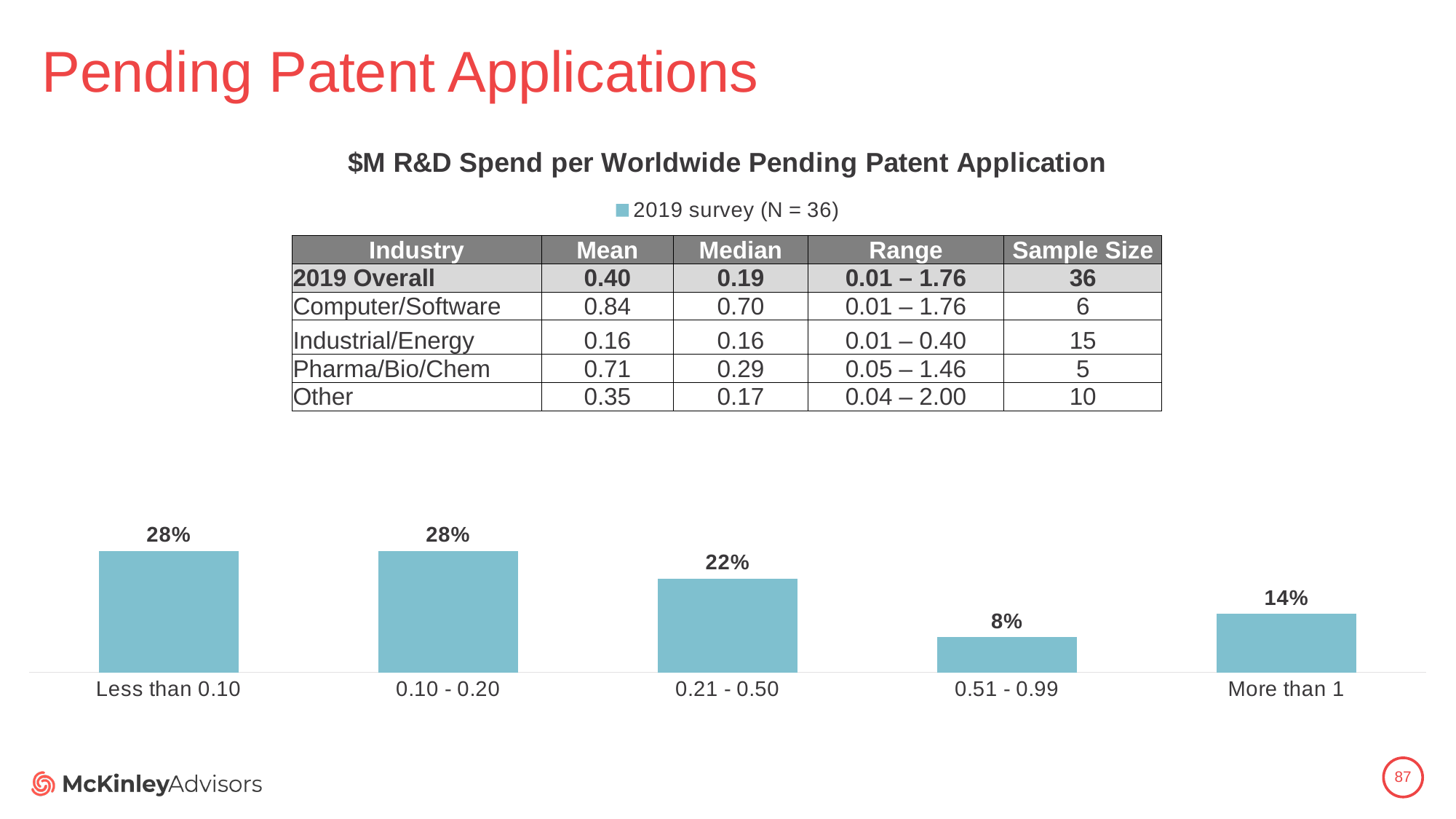
How many categories are shown on the x axis of the chart? 5 Which category has the lowest value in the chart? 0.51 - 0.99 What is the difference between the values for 'Less than 0.10' and 'More than 1'? 14% What is the value shown for the 'More than 1' category? 14% What is the title of the chart? $M R&D Spend per Worldwide Pending Patent Application Which is larger, the value for '0.21 - 0.50' or the value for 'More than 1'? 0.21 - 0.50 What is the value shown for the '0.21 - 0.50' category? 22% What percentage of respondents fall in the 'Less than 0.10' category? 28% What kind of chart is shown on the slide? Bar chart What is the value shown for the '0.51 - 0.99' category? 8% What is the difference between the values for '0.21 - 0.50' and '0.51 - 0.99'? 14% How many series does the legend list? 1